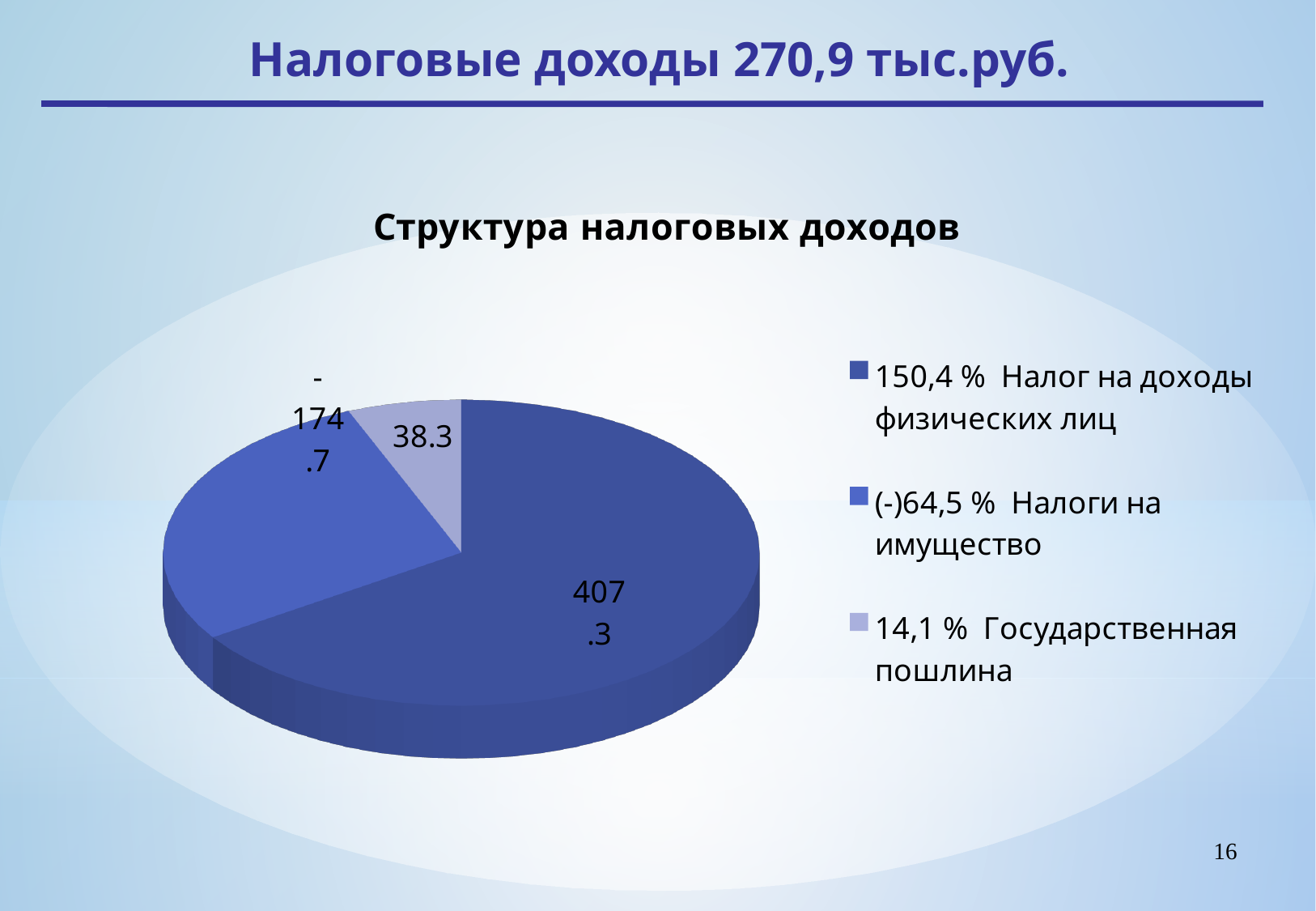
Which category has the smallest slice of the pie? Государственная пошлина What kind of chart is shown on the slide? pie chart What is the value shown for Государственная пошлина? 38.3 How many slices does the pie chart have? 3 What is the value shown for Налоги на имущество? -174.7 What percentage share does the legend give for Государственная пошлина? 14,1 % How many entries does the legend list? 3 What is the title of the chart? Структура налоговых доходов What is the difference between the values for Налог на доходы физических лиц and Государственная пошлина? 369.0 Which category has the largest slice of the pie? Налог на доходы физических лиц What is the value shown for Налог на доходы физических лиц? 407.3 What percentage share does the legend give for Налог на доходы физических лиц? 150,4 %